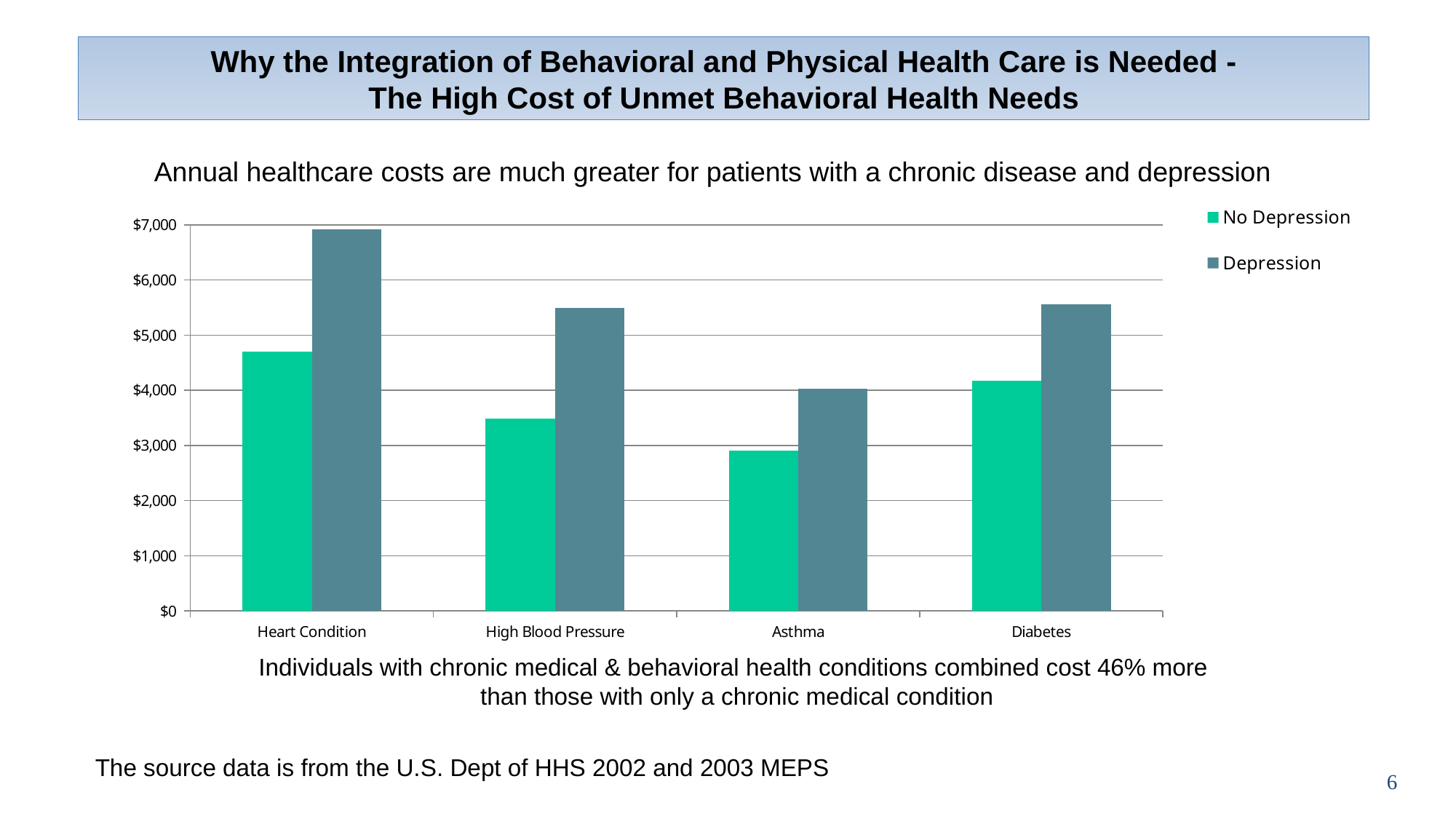
Which condition has the highest annual cost for the Depression series? Heart Condition How many condition categories are shown on the x axis? 4 Which is larger: the No Depression value for Heart Condition or the No Depression value for Diabetes? Heart Condition How many series does the legend list? 2 Is the No Depression value for Heart Condition greater or less than $5,000? less Is the Depression value for Heart Condition greater or less than $6,000? greater Is the Depression value for High Blood Pressure greater or less than $5,000? greater Which condition has the lowest annual cost for the No Depression series? Asthma Which series is shown in green in the legend? No Depression What kind of chart is shown on the slide? bar chart